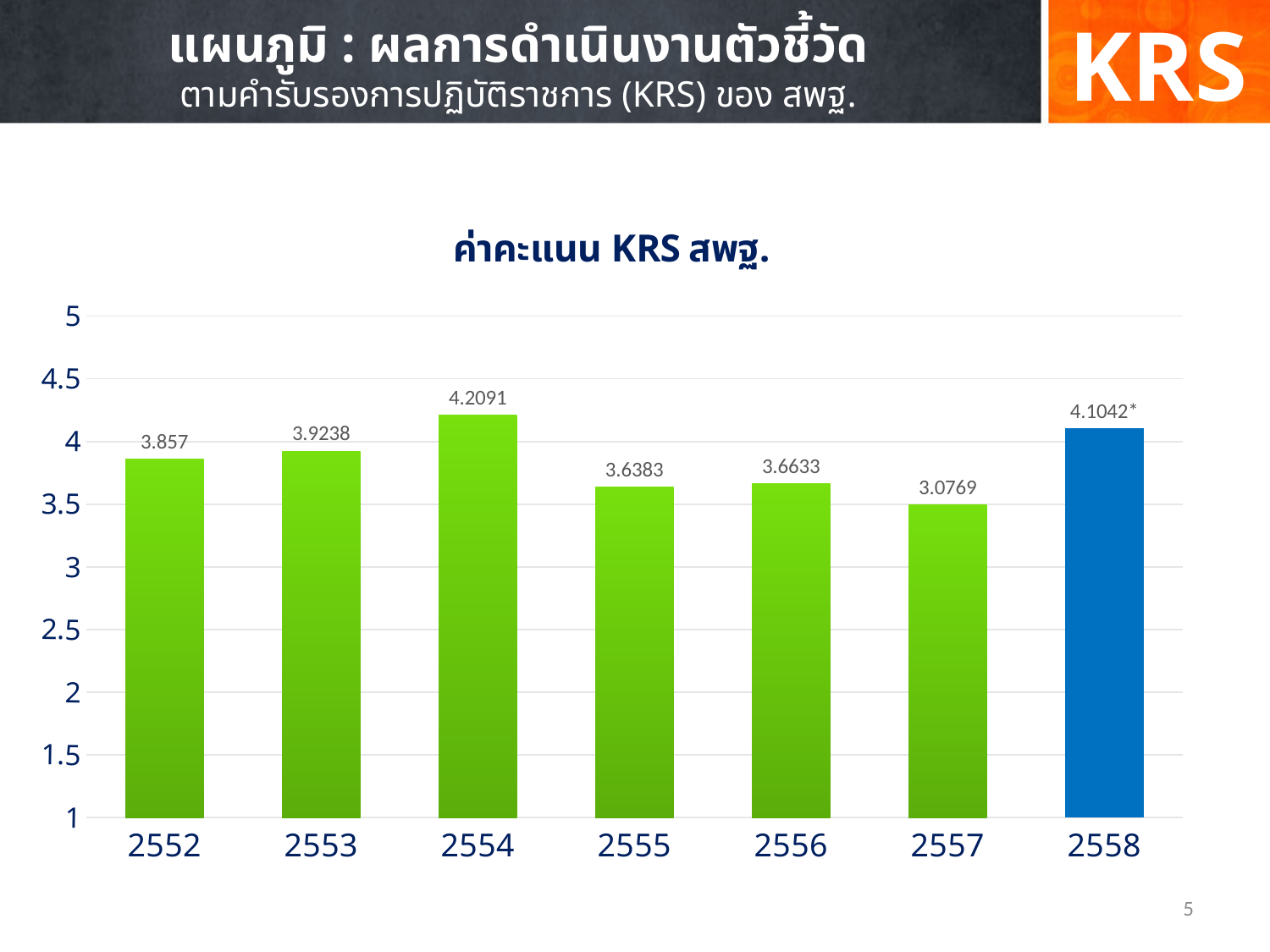
Is the value for 2554 greater or less than 4? greater Which is larger, the value for 2555 or the value for 2556? 2556 What is the difference between the values for 2554 and 2552? 0.3521 Which year has the highest value? 2554 What is the value for 2552? 3.857 What is the value for 2558? 4.1042 Which year's bar is coloured blue instead of green? 2558 What is the value for 2554? 4.2091 What kind of chart is shown on the slide? bar chart Which year has the lowest value? 2557 What is the value for 2557? 3.0769 How many years are shown on the x axis? 7